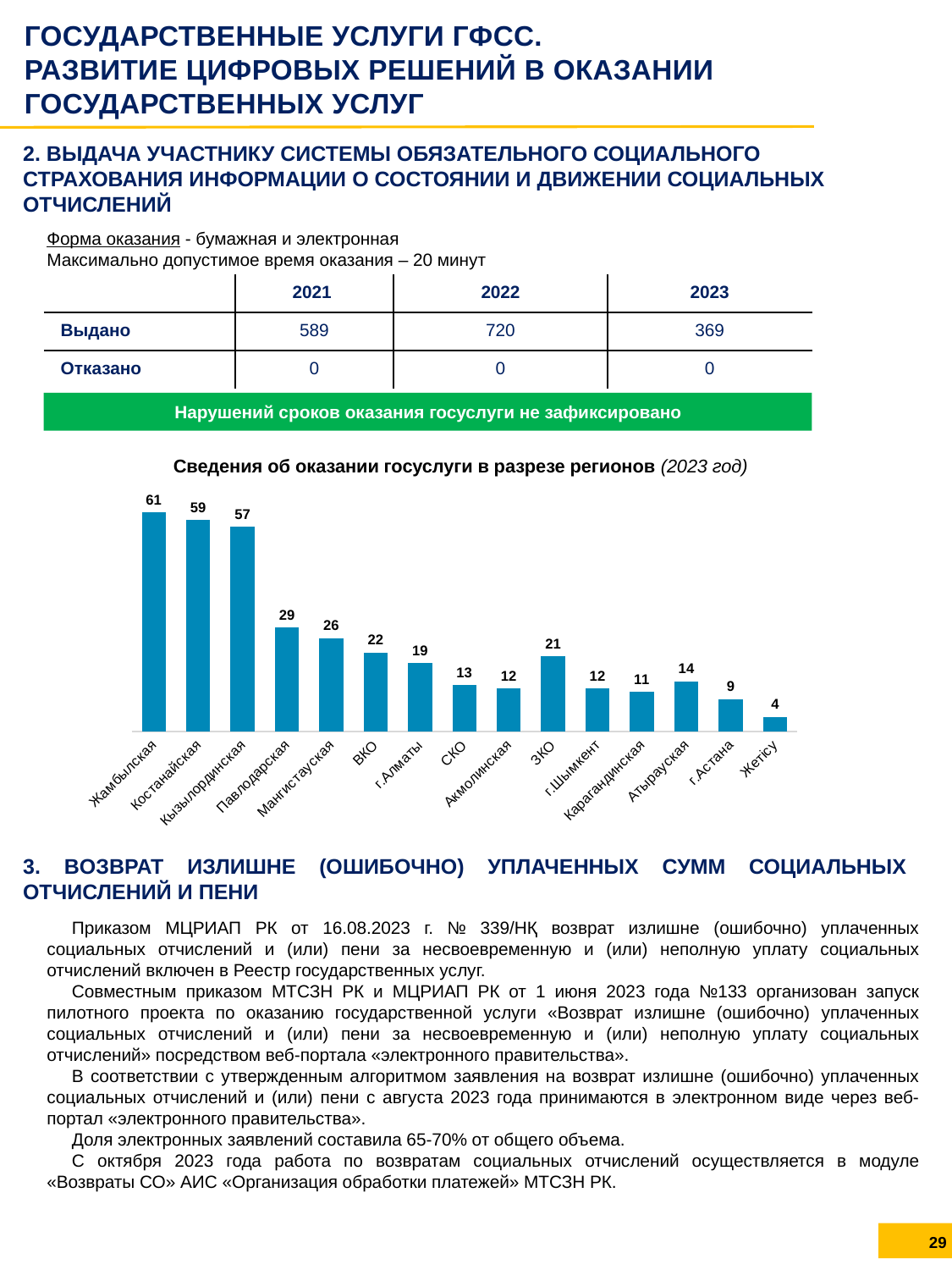
Какой регион имеет наибольшее значение на диаграмме по регионам? Жамбылская Что больше на диаграмме по регионам: значение Мангистауской области или ВКО? Мангистауская Какое значение показано для ЗКО на диаграмме по регионам? 21 Какого типа диаграмма «Сведения об оказании госуслуги в разрезе регионов (2023 год)»? Столбчатая (bar chart) Что больше на диаграмме по регионам: значение СКО или Карагандинской области? СКО Какое значение показано для Жамбылской области на диаграмме «Сведения об оказании госуслуги в разрезе регионов (2023 год)»? 61 Сколько регионов показано на диаграмме «Сведения об оказании госуслуги в разрезе регионов (2023 год)»? 15 На сколько значение Костанайской области больше значения Павлодарской области на диаграмме по регионам? 30 Какой регион имеет наименьшее значение на диаграмме по регионам? Жетісу Какое значение показано для г.Алматы на диаграмме по регионам? 19 На сколько значение Атырауской области больше значения г.Астана на диаграмме по регионам? 5 За какой год приведены данные на диаграмме по регионам? 2023 год